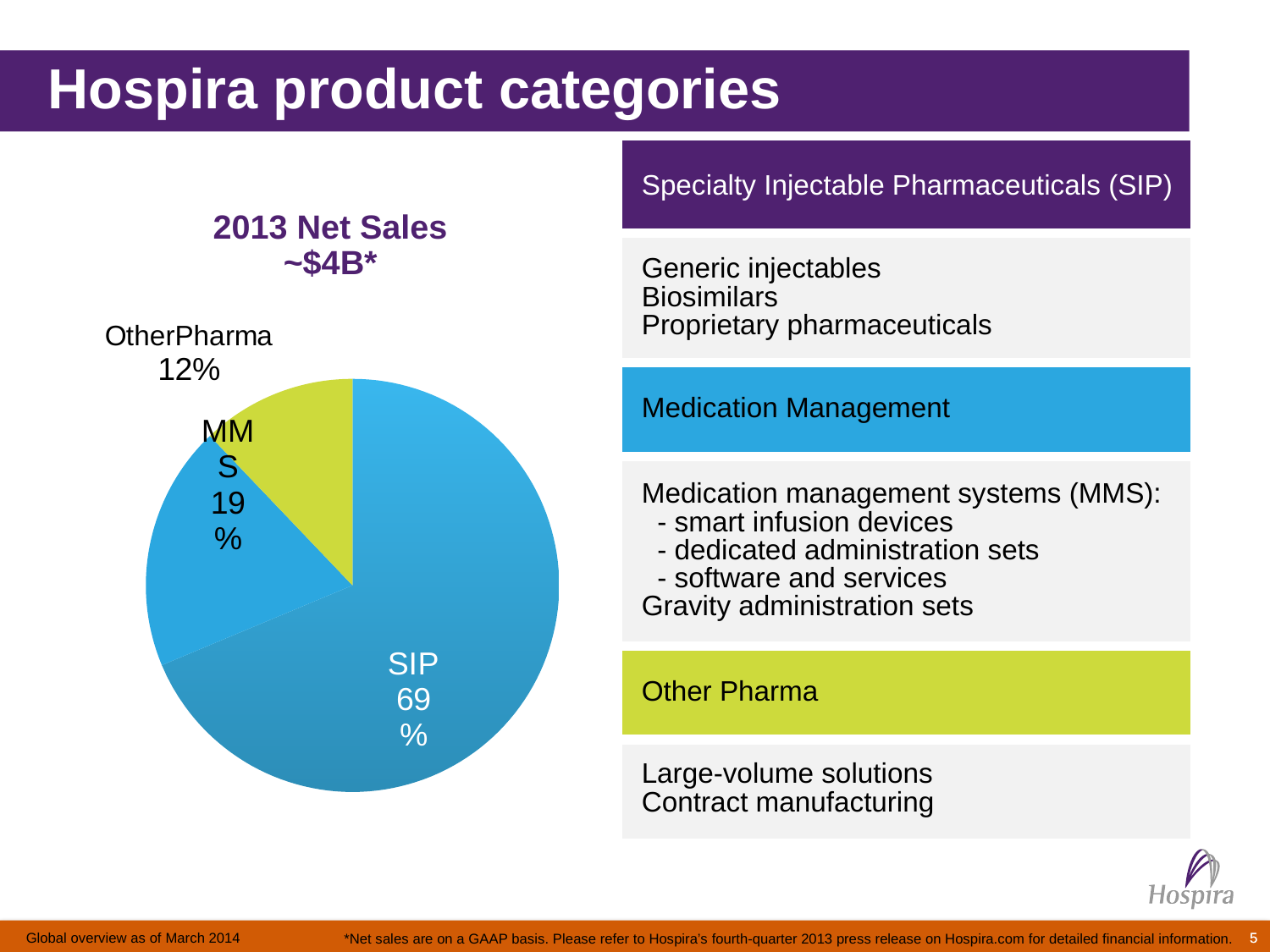
What share of 2013 net sales does SIP account for? 69% What is the difference in percentage points between the SIP share and the MMS share? 50 Which category has the smallest share of 2013 net sales? Other Pharma What share of 2013 net sales does Other Pharma account for? 12% What is the difference in percentage points between the MMS share and the Other Pharma share? 7 Which is larger, the MMS share or the Other Pharma share? MMS What share of 2013 net sales does MMS account for? 19% What colour is the Other Pharma slice of the pie chart? yellow-green What is the title of the pie chart? 2013 Net Sales ~$4B* How many slices does the pie chart have? 3 What kind of chart is shown on the slide? pie chart Which category has the largest share of 2013 net sales? SIP